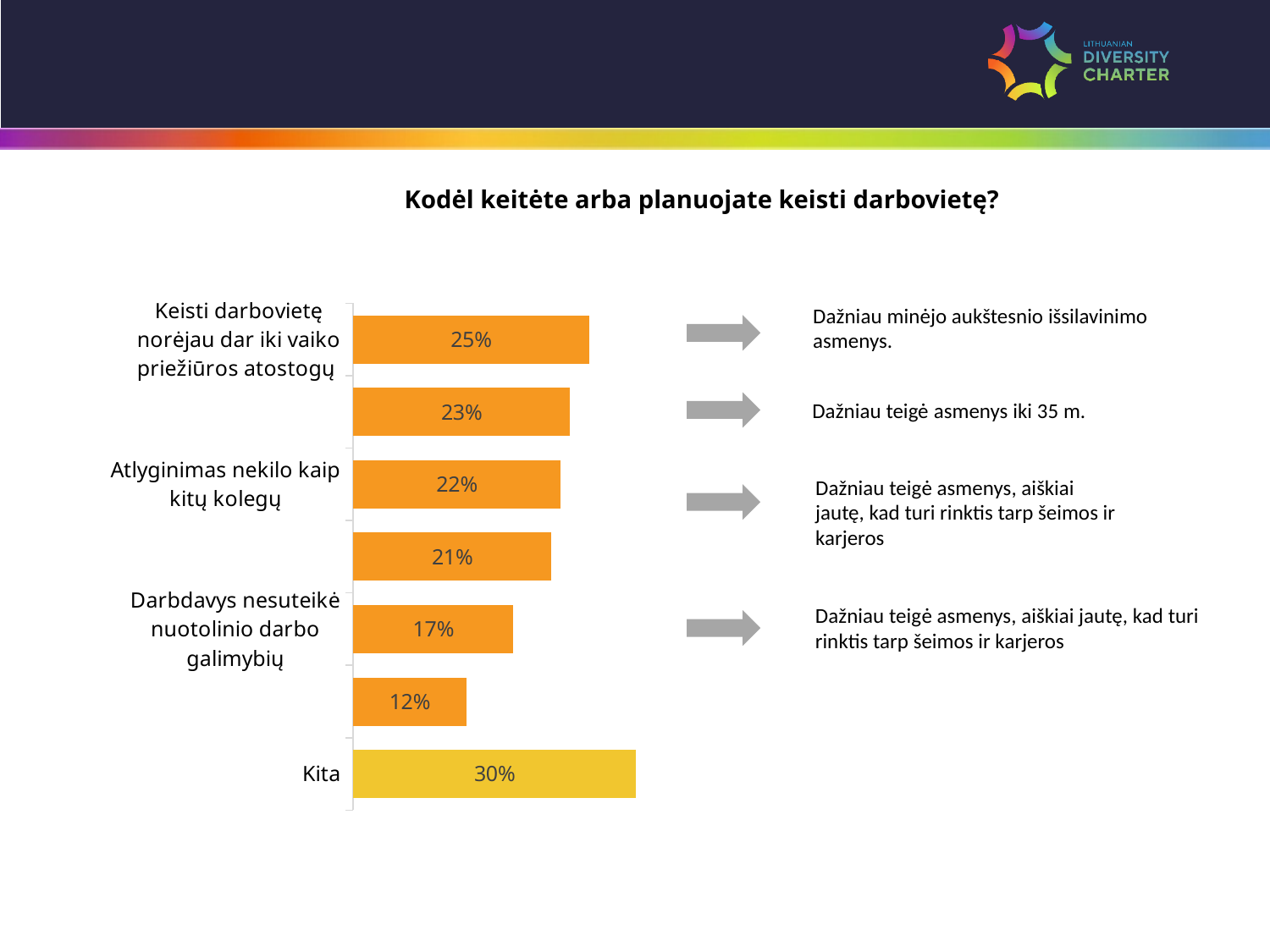
What is the value for "Darbdavys nesuteikė nuotolinio darbo galimybių"? 17% How many bars are shown on the chart? 7 What kind of chart is shown on the slide? Bar chart Which is larger, the value for "Kita" or the value for "Keisti darbovietę norėjau dar iki vaiko priežiūros atostogų"? Kita What is the difference between the values for "Kita" and "Atlyginimas nekilo kaip kitų kolegų"? 8% What is the value for "Kita"? 30% What is the lowest value shown on the chart? 12% What is the title of the chart? Kodėl keitėte arba planuojate keisti darbovietę? Which category has the highest value? Kita What is the difference between the values for "Keisti darbovietę norėjau dar iki vaiko priežiūros atostogų" and "Darbdavys nesuteikė nuotolinio darbo galimybių"? 8% What is the value for "Atlyginimas nekilo kaip kitų kolegų"? 22% What is the value for "Keisti darbovietę norėjau dar iki vaiko priežiūros atostogų"? 25%